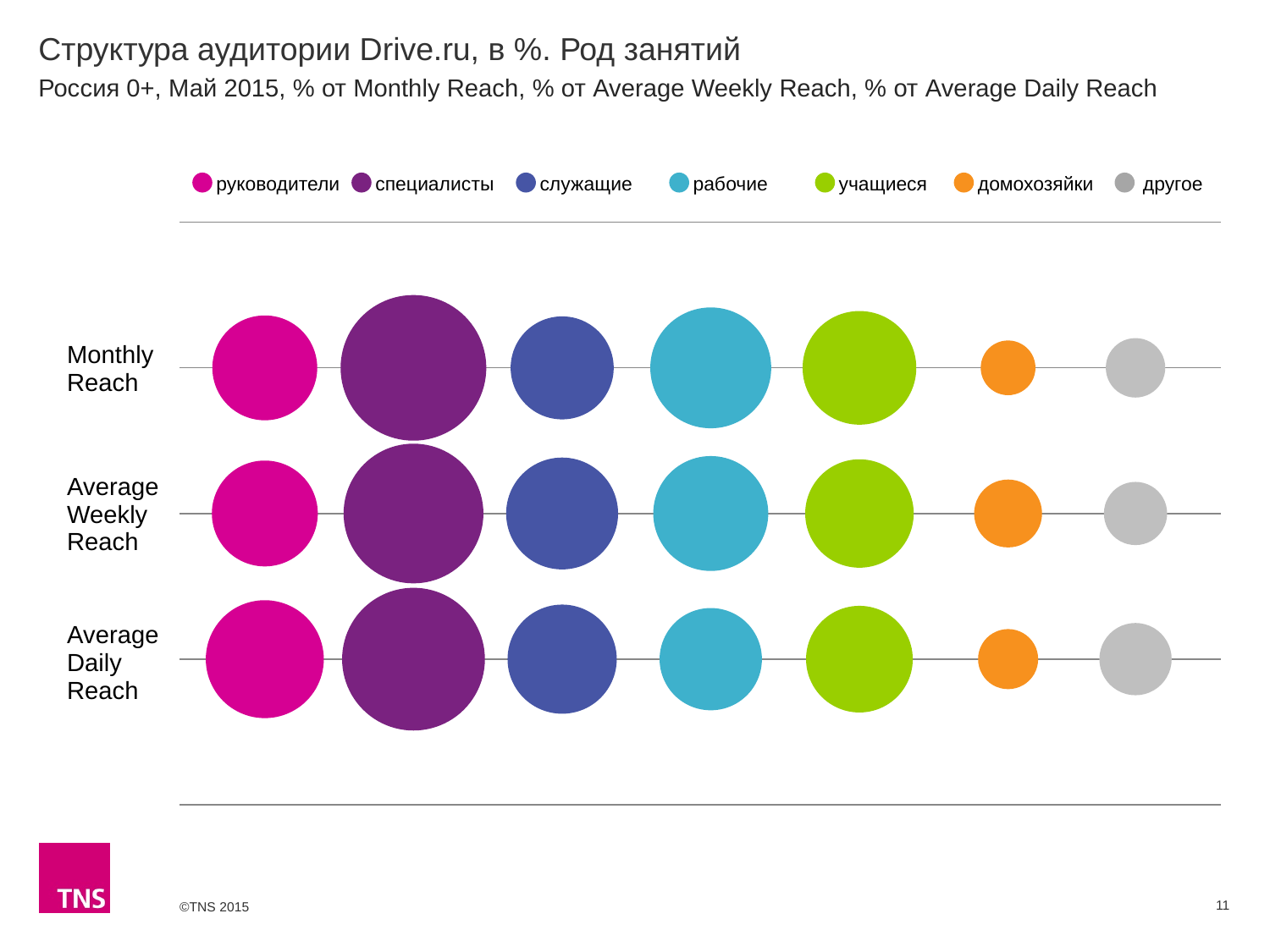
How many occupation categories does the legend list? 7 What kind of chart is shown on the slide? bubble chart Which occupation category has the largest bubble in the Monthly Reach row? специалисты In the Monthly Reach row, which bubble is larger: рабочие or служащие? рабочие Which occupation category has the largest bubble in the Average Daily Reach row? специалисты In the Average Daily Reach row, which bubble is larger: руководители or домохозяйки? руководители In the Monthly Reach row, which bubble is larger: специалисты or руководители? специалисты How many reach rows (Monthly, Weekly, Daily) are plotted in the chart? 3 What is the title of the chart on the slide? Структура аудитории Drive.ru, в %. Род занятий Which occupation category is shown in orange in the legend? домохозяйки